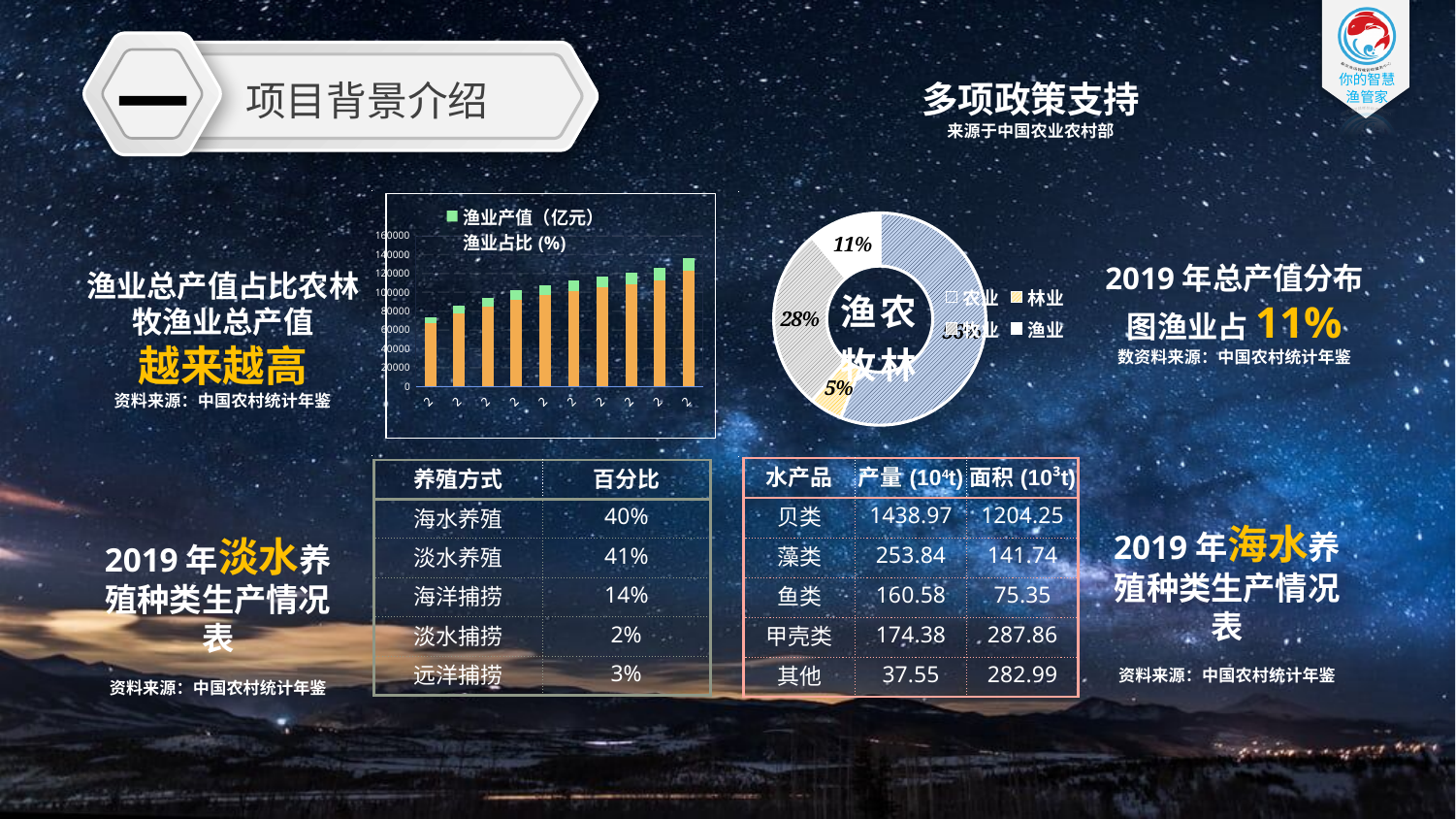
In the middle doughnut chart, what share does 渔业 hold? 11% In the middle doughnut chart, which is larger, the slice labelled 28% or the slice labelled 5%? the slice labelled 28% What text is written in the centre of the middle doughnut chart? 渔农牧林 In the left bar chart, is the total height of the last (rightmost) bar greater or less than 100000? greater What kind of chart is the chart in the middle of the slide with the legend 农业, 林业, 牧业, 渔业? doughnut chart In the left bar chart, which bar is the tallest, the leftmost or the rightmost? the rightmost How many bars are plotted in the left bar chart? 10 What kind of chart is the chart on the left with the legend 渔业产值 (亿元) and 渔业占比 (%)? bar chart In the left bar chart, is the total height of the first (leftmost) bar greater or less than 80000? less In the left bar chart, do the bar heights generally rise or fall from left to right? rise How many categories does the legend of the middle doughnut chart list? 4 How many series does the legend of the left bar chart list? 2